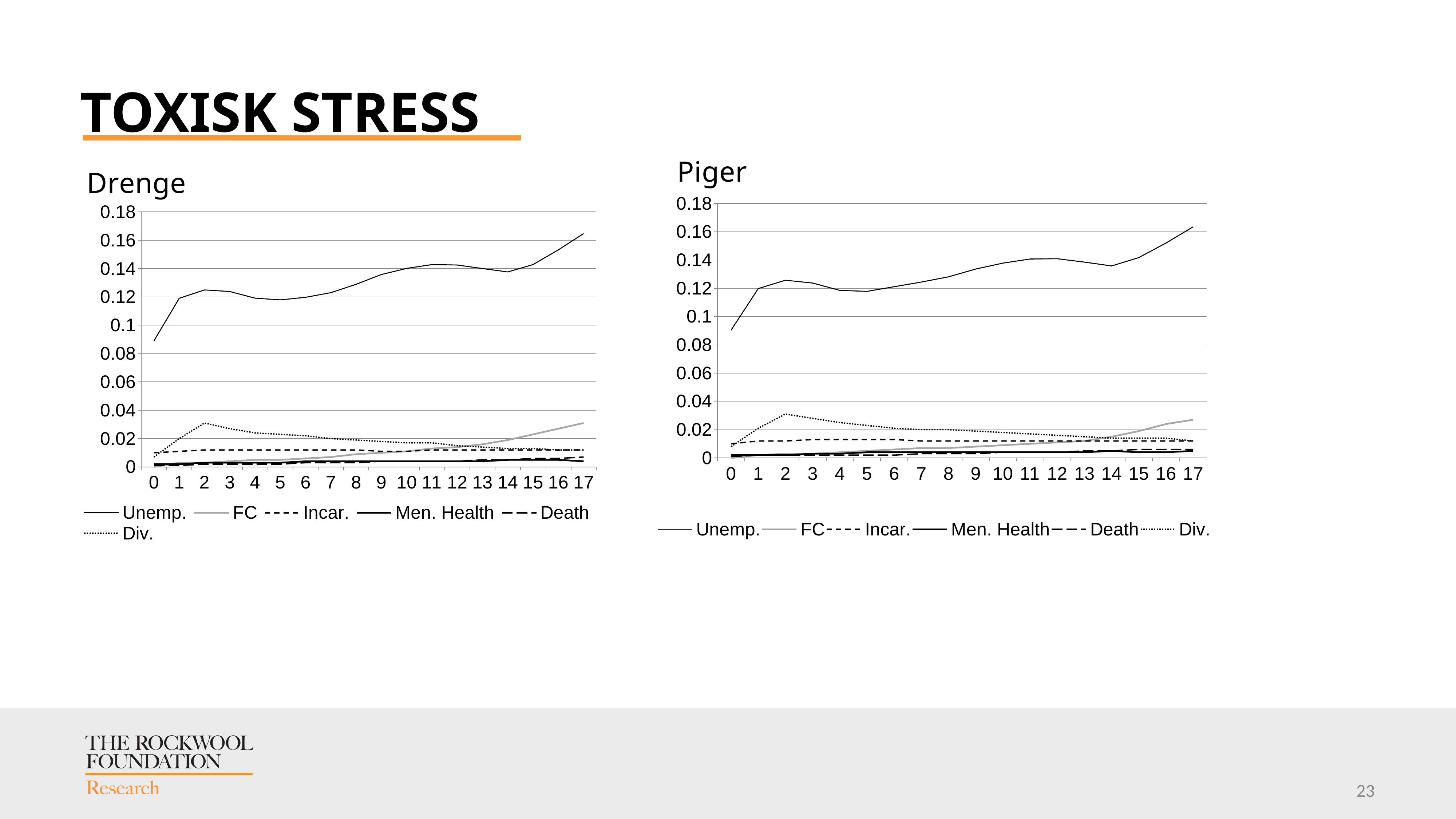
In the Piger chart, does the Unemp. series overall rise or fall from 0 to 17? rise How many series does the legend of the Piger chart list? 6 What kind of chart is the Drenge chart? line chart How many points along the x axis does the Drenge chart have? 18 In the Drenge chart, is the value of Unemp. at 17 greater or less than 0.14? greater In the Drenge chart, is the value of Unemp. at 0 greater or less than 0.1? less In the Drenge chart, is the value of Div. at 2 greater or less than 0.02? greater In the Drenge chart, which is larger at 17: FC or Incar.? FC In the Piger chart, which series has the highest values across the x axis? Unemp. In the Drenge chart, which series has the highest values across the x axis? Unemp. What is the title of the chart on the right of the slide? Piger